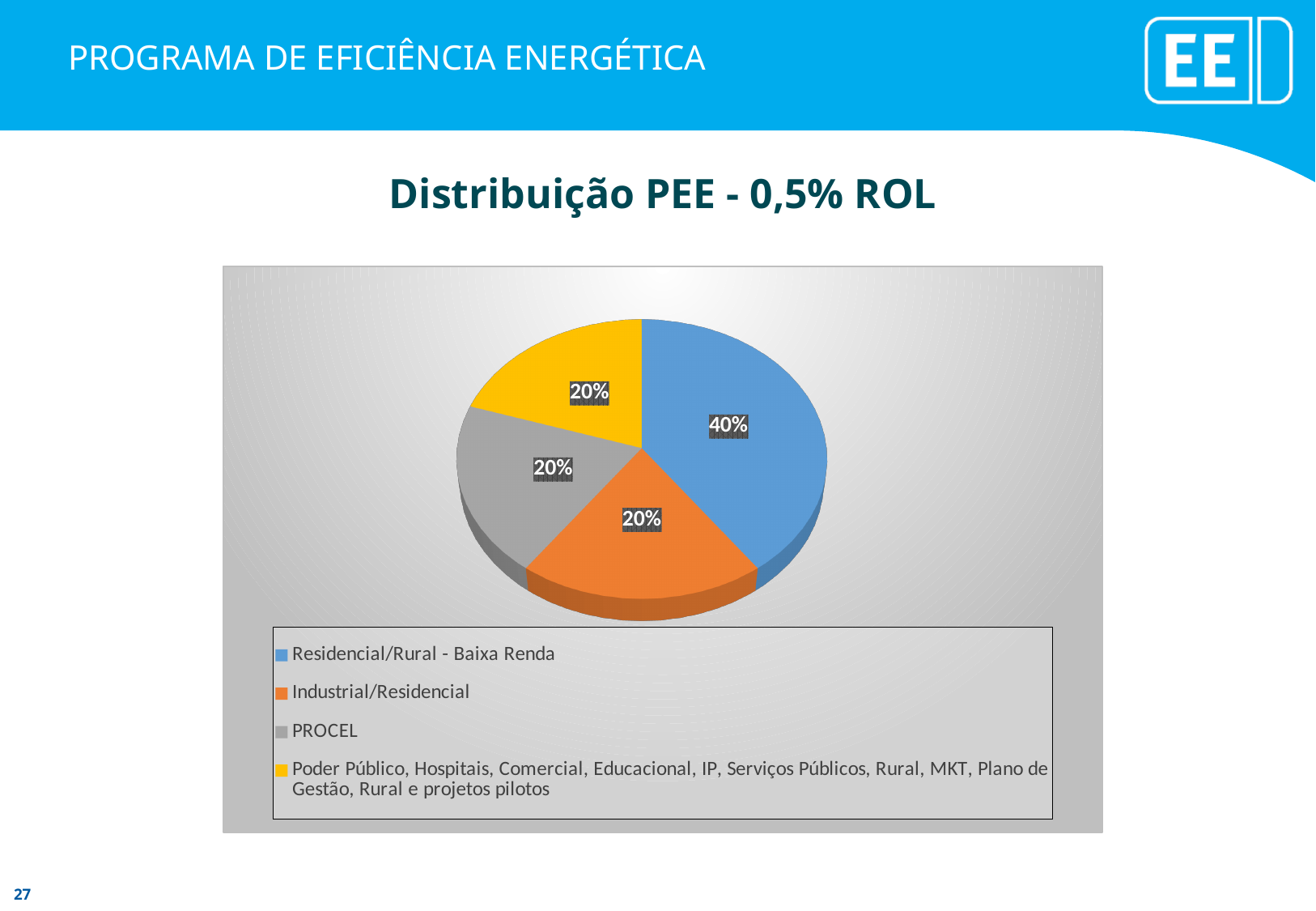
How many entries does the legend list? 4 What share of the pie does Residencial/Rural - Baixa Renda represent? 40% What share of the pie does PROCEL represent? 20% What share of the pie does Industrial/Residencial represent? 20% Which colour represents PROCEL in the pie chart? Gray What is the difference in percentage points between Residencial/Rural - Baixa Renda and PROCEL? 20 percentage points Which is larger: the share for Residencial/Rural - Baixa Renda or the share for Industrial/Residencial? Residencial/Rural - Baixa Renda What type of chart is shown on the slide? Pie chart What percentage is shown for the yellow slice (Poder Público, Hospitais, Comercial, Educacional, IP, Serviços Públicos, Rural, MKT, Plano de Gestão, Rural e projetos pilotos)? 20% Which category has the largest share of the pie? Residencial/Rural - Baixa Renda How many slices does the pie chart have? 4 What is the title of the chart? Distribuição PEE - 0,5% ROL